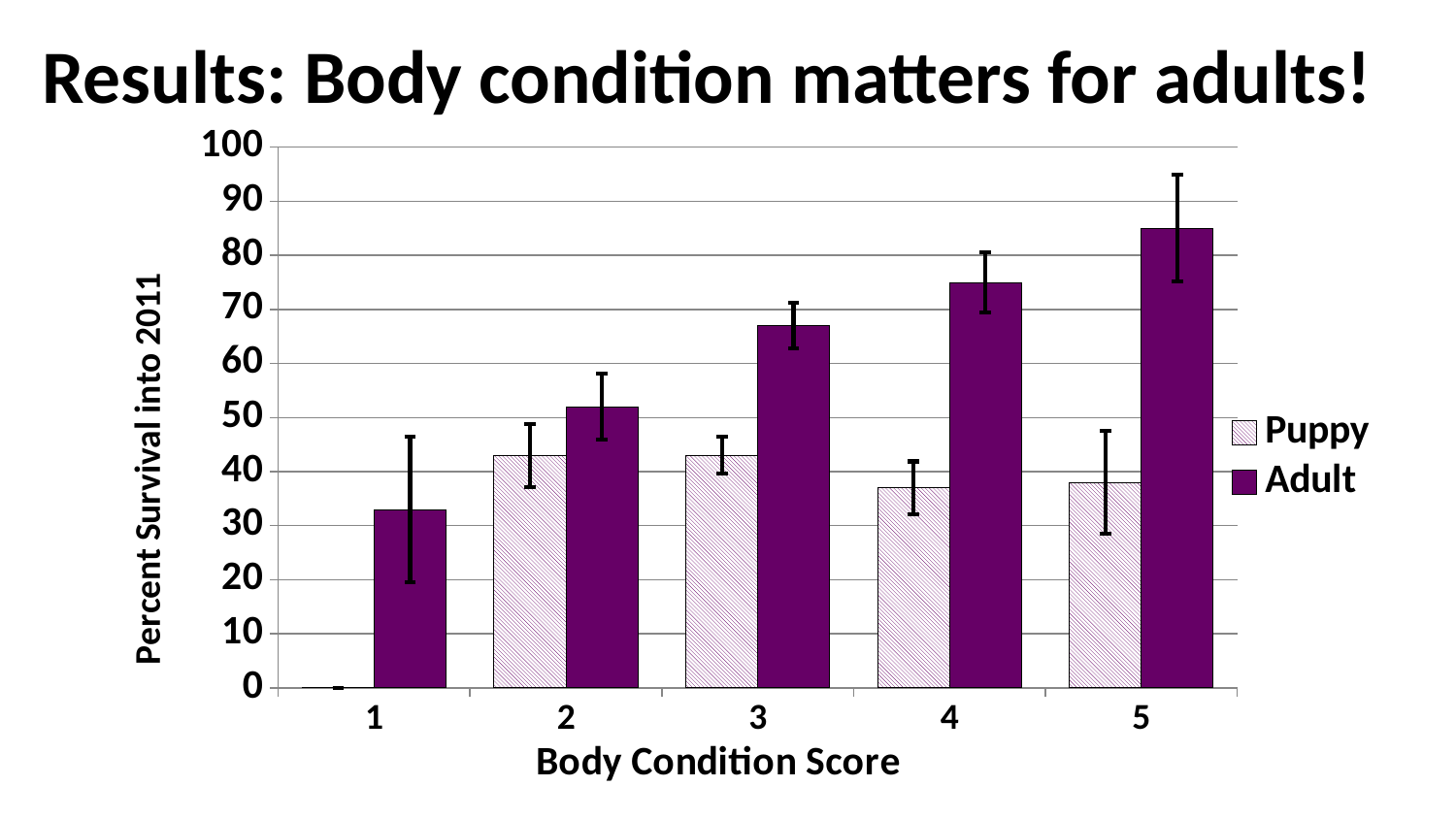
What is the title of the y axis? Percent Survival into 2011 At body condition score 3, which series has the larger value, Puppy or Adult? Adult What is the title of the x axis? Body Condition Score Which body condition score has the highest Adult survival? 5 What kind of chart is shown on the slide? bar chart Do the Adult values rise or fall as the body condition score increases from 1 to 5? rise How many series does the legend list? 2 Is the Adult value at body condition score 5 greater or less than 80? greater How many body condition score categories are shown on the x axis? 5 Which body condition score has the lowest Adult survival? 1 Is the Puppy value at body condition score 4 greater or less than 40? less Is the Adult value at body condition score 3 greater or less than 70? less